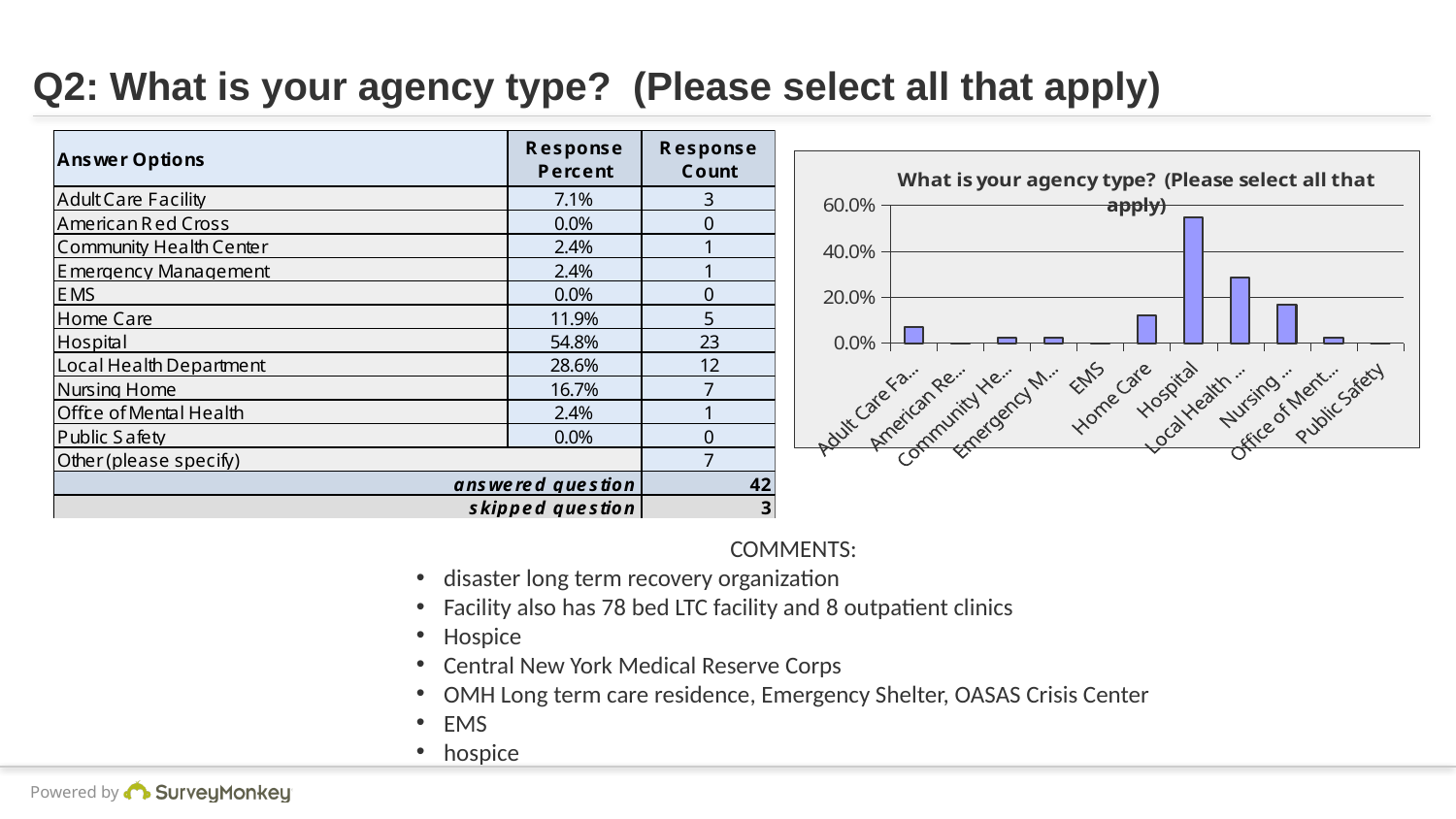
Which category has the highest bar in the chart? Hospital What is the title of the chart? What is your agency type? (Please select all that apply) Is the value for Home Care greater or less than 20.0%? less What kind of chart is shown on the slide? bar chart According to the table, what is the response percent for Hospital? 54.8% Is the value for Hospital greater or less than 40.0%? greater Is the value for Local Health Department greater or less than 40.0%? less How many categories are plotted on the chart's x axis? 11 Which bar is taller, Local Health Department or Nursing Home? Local Health Department According to the table, what is the difference in response percent between Hospital and Local Health Department? 26.2% Which bar is taller, Home Care or Adult Care Facility? Home Care According to the table, what is the response count for Local Health Department? 12